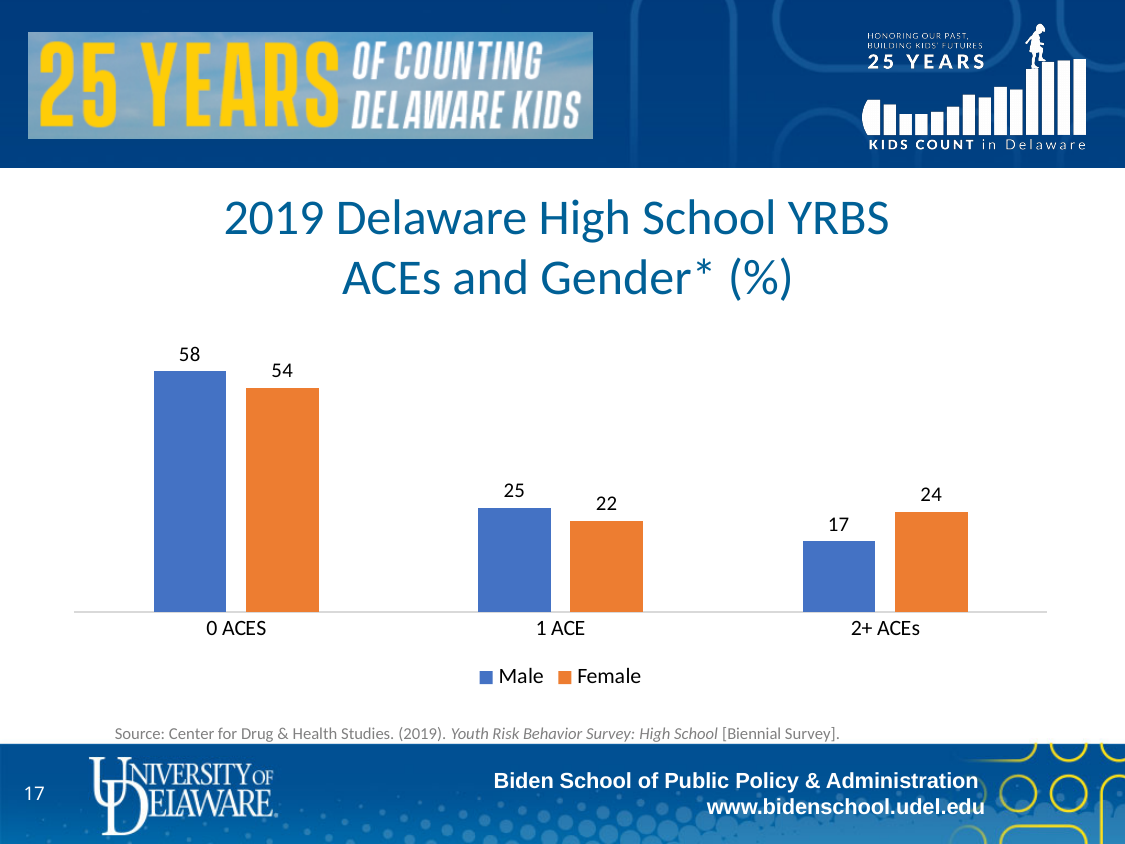
What is the value for Female in the 2+ ACEs category? 24 Which colour represents the Female series? Orange What kind of chart is shown on the slide? Bar chart What is the value for Male in the 0 ACES category? 58 Which category has the highest Male value? 0 ACES What is the difference between the Male and Female values in the 0 ACES category? 4 How many series does the legend list? 2 What is the difference between the Female and Male values in the 2+ ACEs category? 7 What is the value for Female in the 1 ACE category? 22 In the 1 ACE category, which is larger, the Male or the Female value? Male How many categories are shown on the x axis? 3 Which category has the lowest Female value? 1 ACE